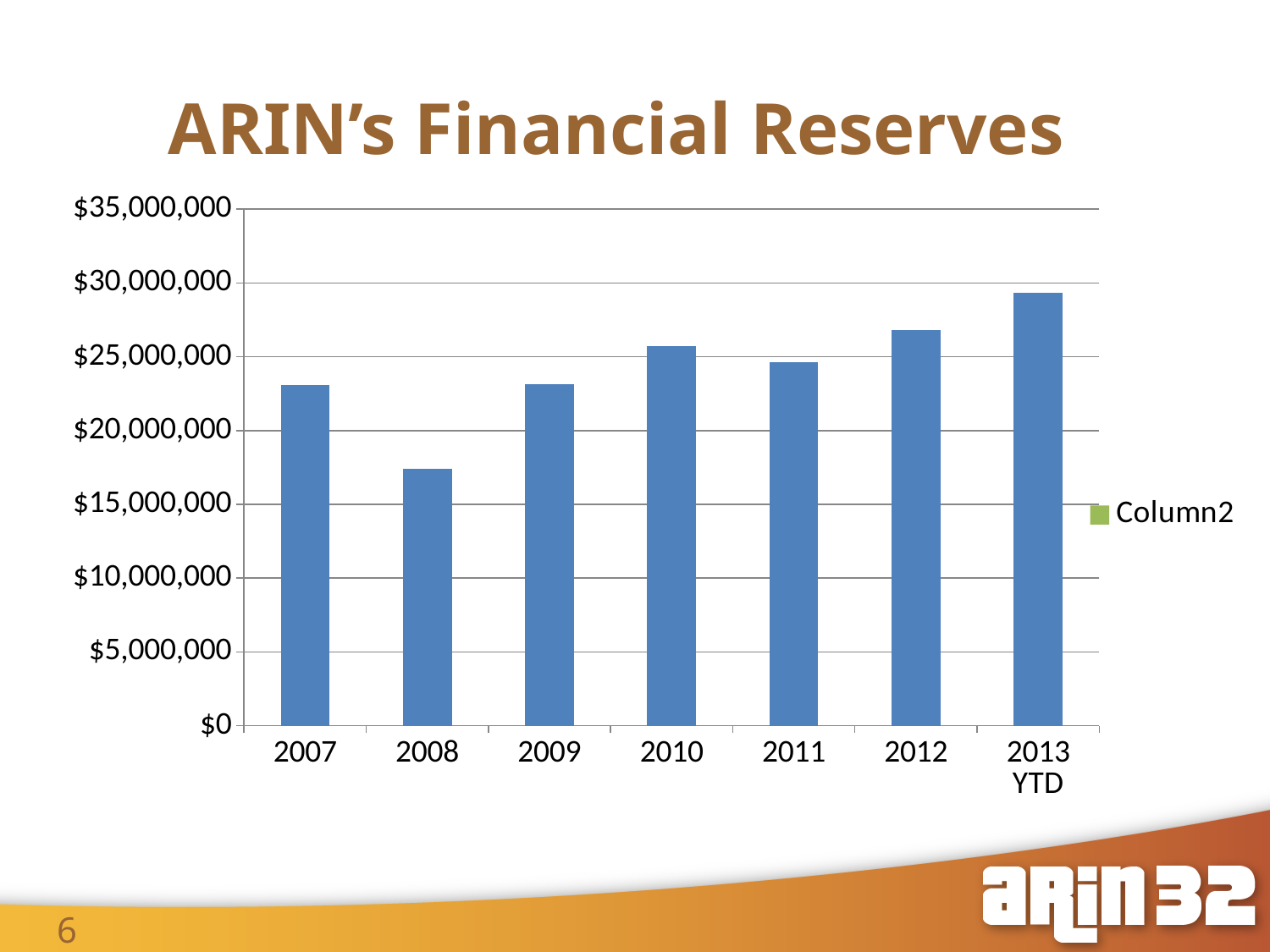
How many years (categories) are shown on the x axis? 7 Which year has the lowest financial reserves? 2008 Which is larger, the value for 2011 or the value for 2012? 2012 Which year has the highest financial reserves? 2013 YTD Is the value for 2010 greater or less than $25,000,000? greater Which is larger, the value for 2007 or the value for 2008? 2007 Do the values rise or fall from 2008 to 2010? rise Is the value for 2007 greater or less than $25,000,000? less What kind of chart is shown on the slide? bar chart Is the value for 2008 greater or less than $20,000,000? less What is the title of the chart? ARIN's Financial Reserves